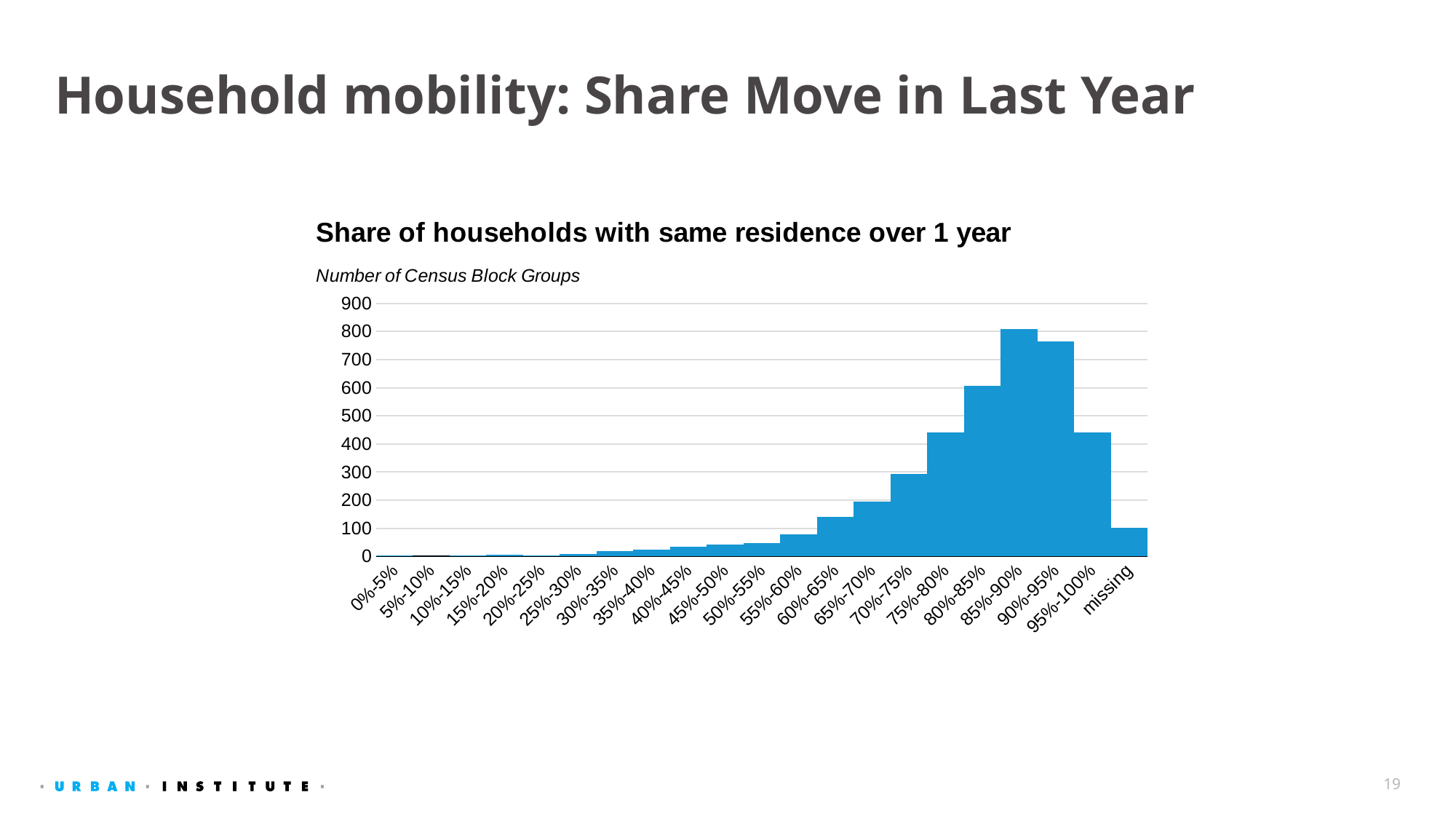
Which is larger, the value for 90%-95% or the value for 95%-100%? 90%-95% How many categories are shown on the x axis? 21 Which category has the highest number of census block groups? 85%-90% Is the value for 85%-90% greater or less than 700? greater Is the value for 90%-95% greater or less than 700? greater Is the value for 70%-75% greater or less than 200? greater What kind of chart is shown on the slide? bar chart What is the title of the chart? Share of households with same residence over 1 year Do the values generally rise or fall from 0%-5% to 85%-90%? rise